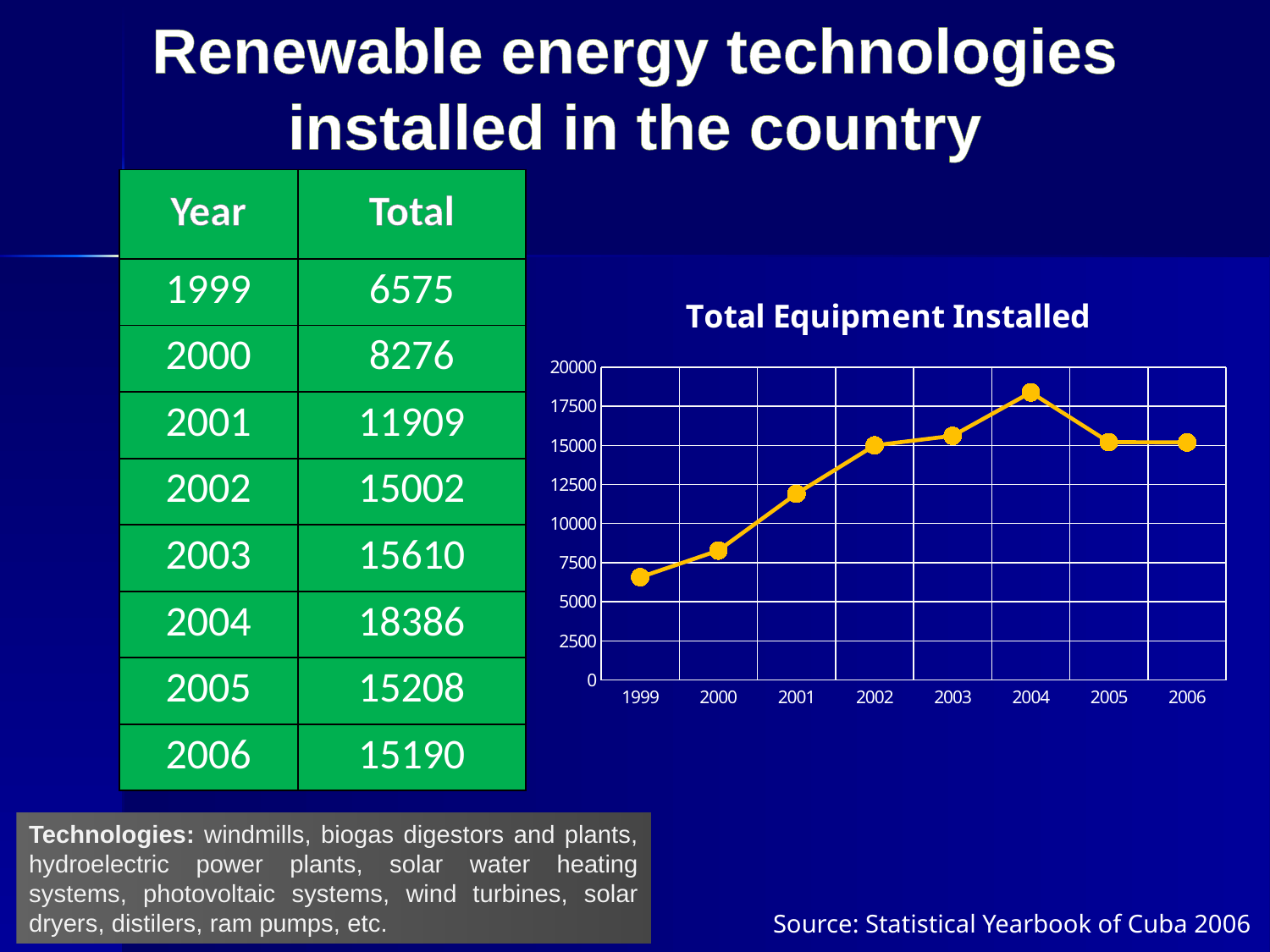
Is the value for 2001 in the "Total Equipment Installed" chart greater or less than 12500? less In which year does the "Total Equipment Installed" chart reach its highest value? 2004 Is the value for 2004 in the "Total Equipment Installed" chart greater or less than 17500? greater In which year does the "Total Equipment Installed" chart show its lowest value? 1999 How many years are plotted on the x axis of the "Total Equipment Installed" chart? 8 What is the difference between the total equipment installed in 2004 and in 2005? 3178 What kind of chart is "Total Equipment Installed"? line chart Which year has the larger total equipment installed, 2001 or 2003? 2003 According to the slide, what was the total equipment installed in 1999? 6575 Does the "Total Equipment Installed" chart rise or fall from 1999 to 2004? rise According to the slide, what was the total equipment installed in 2004? 18386 What is the title of the line chart on the slide? Total Equipment Installed